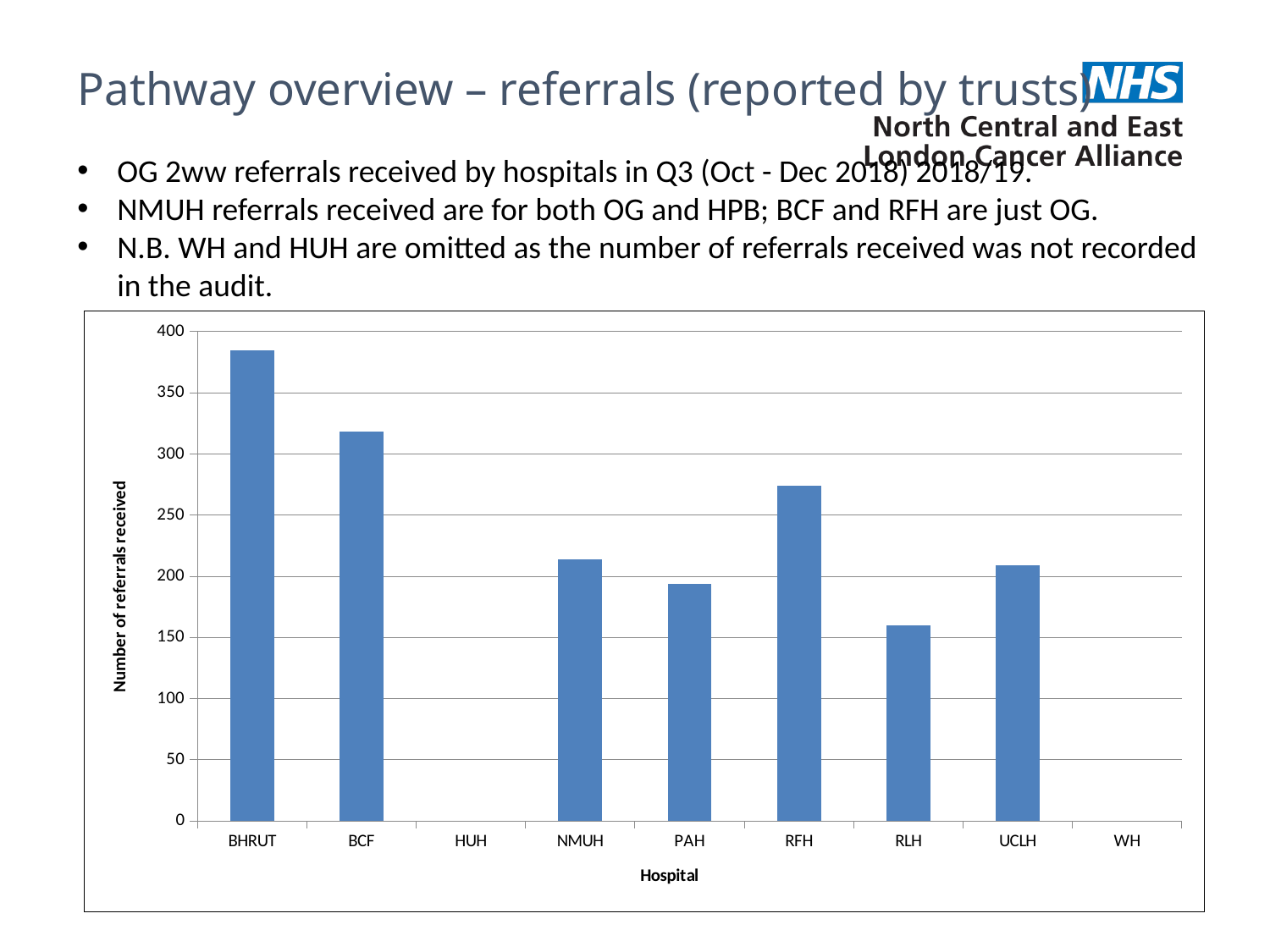
Is the value for BCF greater or less than 300? greater What kind of chart is shown on the slide? bar chart What is the title of the vertical axis? Number of referrals received Which hospital has the highest number of referrals received? BHRUT Which hospital received more referrals, PAH or RLH? PAH Among the hospitals with a bar shown, which has the lowest number of referrals received? RLH Which hospital received more referrals, BCF or RFH? BCF Is the value for BHRUT greater or less than 350? greater Is the value for RFH greater or less than 250? greater How many hospitals have a bar plotted in the chart? 7 How many hospitals are listed on the x axis of the chart? 9